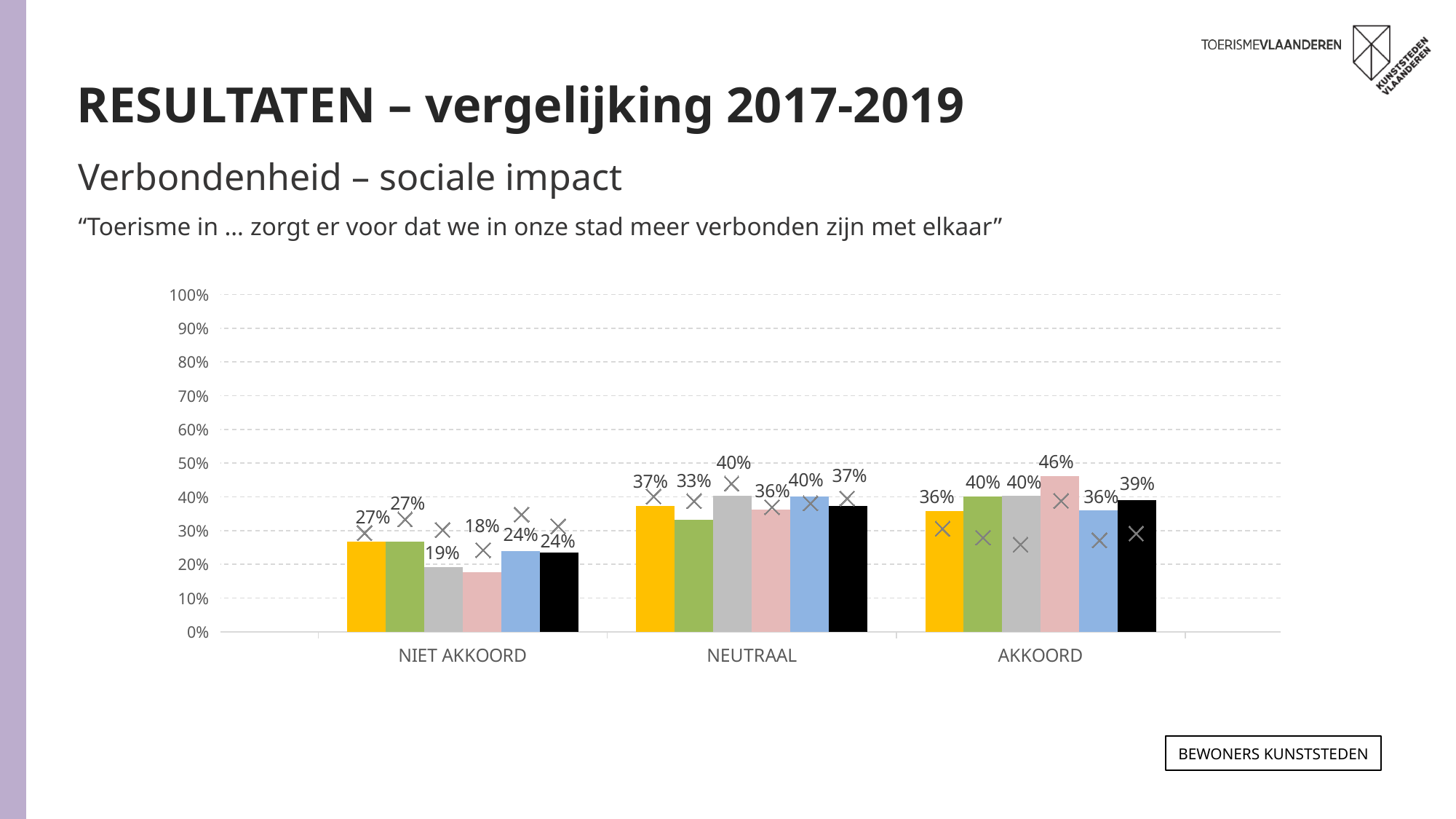
Which bar has the highest value in the AKKOORD category? the pink bar (46%) What is the label of the middle category on the x axis? NEUTRAAL How many categories are shown on the x axis of the chart? 3 What is the difference between the pink bar in AKKOORD (46%) and the pink bar in NIET AKKOORD (18%)? 28 percentage points What is the value of the yellow bar in the NEUTRAAL category? 37% What is the value of the pink bar in the AKKOORD category? 46% What is the value of the black bar in the AKKOORD category? 39% Which is larger: the green bar in NEUTRAAL or the green bar in AKKOORD? the green bar in AKKOORD (40%) Which bar has the lowest value in the NIET AKKOORD category? the pink bar (18%) Is the value of the grey bar in the NIET AKKOORD category greater or less than 20%? less What is the value of the pink bar in the NIET AKKOORD category? 18% What type of chart is shown on the slide? bar chart